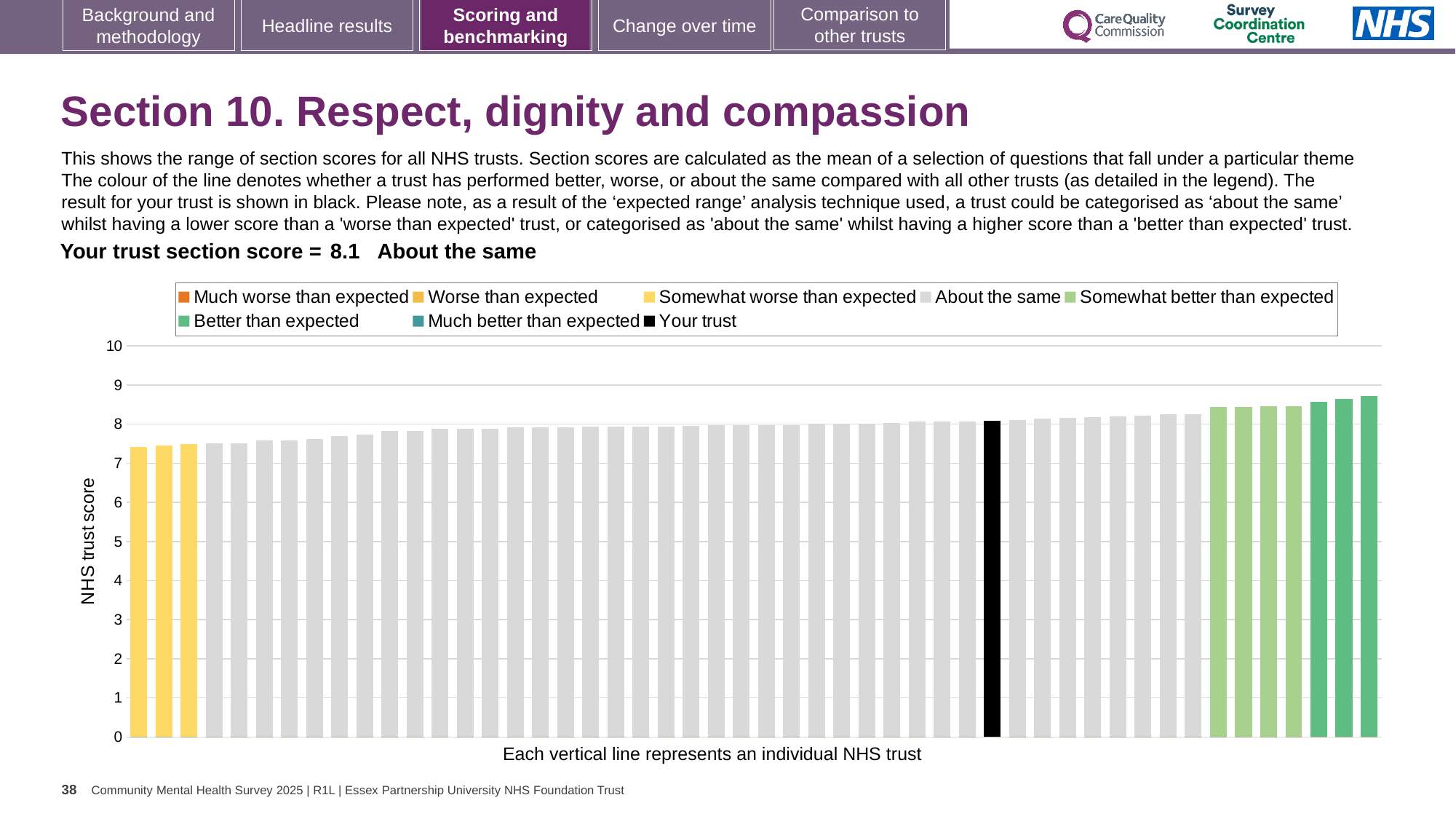
Do the bar values rise or fall from left to right along the x axis? rise Is the value of the tallest bar in the chart greater or less than 9? less What is the label on the vertical axis of the chart? NHS trust score Which is larger: the value of the black 'Your trust' bar or the value of the leftmost bar? the black 'Your trust' bar Is the value of the black 'Your trust' bar greater or less than 8? greater Is the value of the shortest bar in the chart greater or less than 7? greater Which category is your trust's section score placed in? About the same What is the section score for your trust shown on the slide? 8.1 What kind of chart is shown on the slide? bar chart How many entries does the chart legend list? 8 How many bars are coloured green (Somewhat better or Better than expected) in the chart? 7